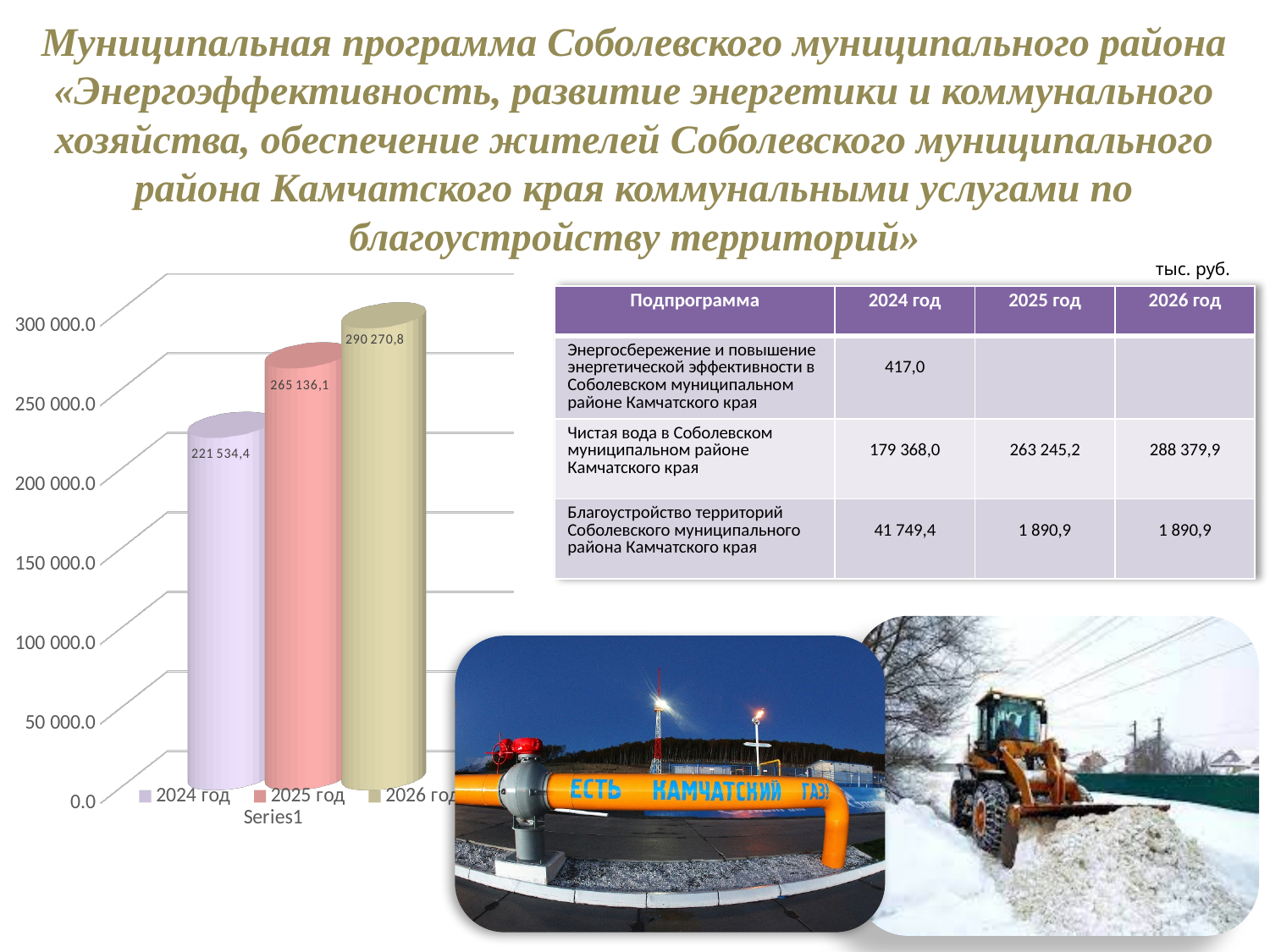
What is the value shown for 2025 год on the bar chart? 265 136,1 What is the difference between the values for 2026 год and 2025 год on the bar chart? 25 134,7 What is the difference between the values for 2025 год and 2024 год on the bar chart? 43 601,7 Which year has the highest bar on the chart? 2026 год What is the value shown for 2026 год on the bar chart? 290 270,8 Which year has the lowest bar on the chart? 2024 год How many entries does the legend of the bar chart list? 3 How many bars are plotted on the chart? 3 Do the bar values rise or fall from 2024 год to 2026 год? rise Which is larger on the bar chart, the value for 2024 год or the value for 2025 год? 2025 год Is the value for 2024 год on the bar chart greater or less than 250 000.0? less What is the value shown for 2024 год on the bar chart? 221 534,4